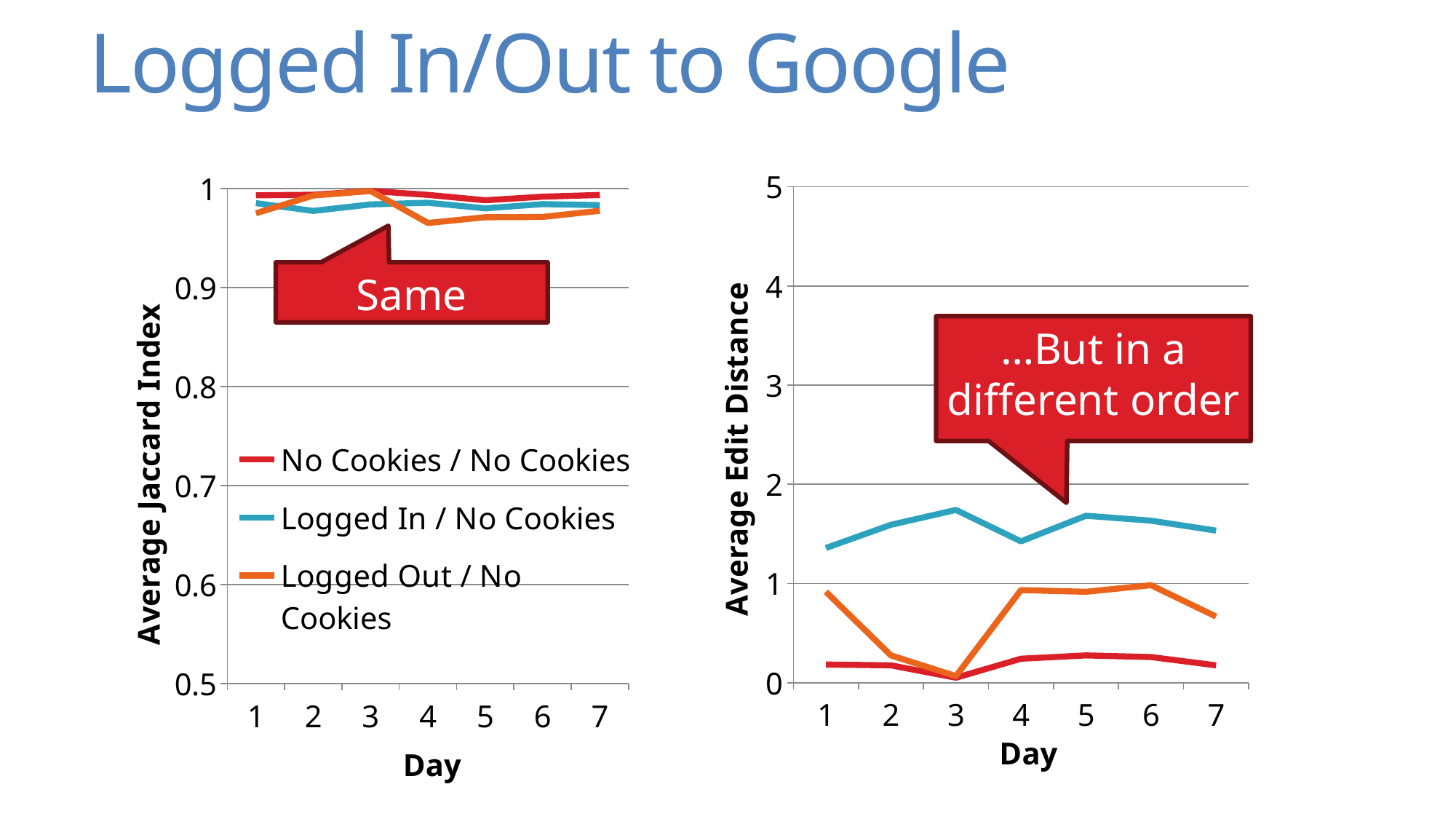
How many series does the legend on the left chart list? 3 On the left chart (Average Jaccard Index), is the value for No Cookies / No Cookies on day 1 greater or less than 0.9? greater On the right chart (Average Edit Distance), on which day does the orange line reach its lowest value? Day 3 How many days are plotted along the x axis of the right chart (Average Edit Distance)? 7 On the right chart (Average Edit Distance), which is larger on day 1: the orange line or the red line? the orange line On the right chart (Average Edit Distance), is the value of the blue line on day 5 greater or less than 2? less What kind of chart is the left chart (Average Jaccard Index)? line chart On the right chart (Average Edit Distance), does the orange line rise or fall from day 3 to day 4? rise On the right chart (Average Edit Distance), is the value of the blue line on day 3 greater or less than 1? greater What is the y-axis title of the left chart? Average Jaccard Index On the right chart (Average Edit Distance), which is larger on day 3: the blue line or the orange line? the blue line